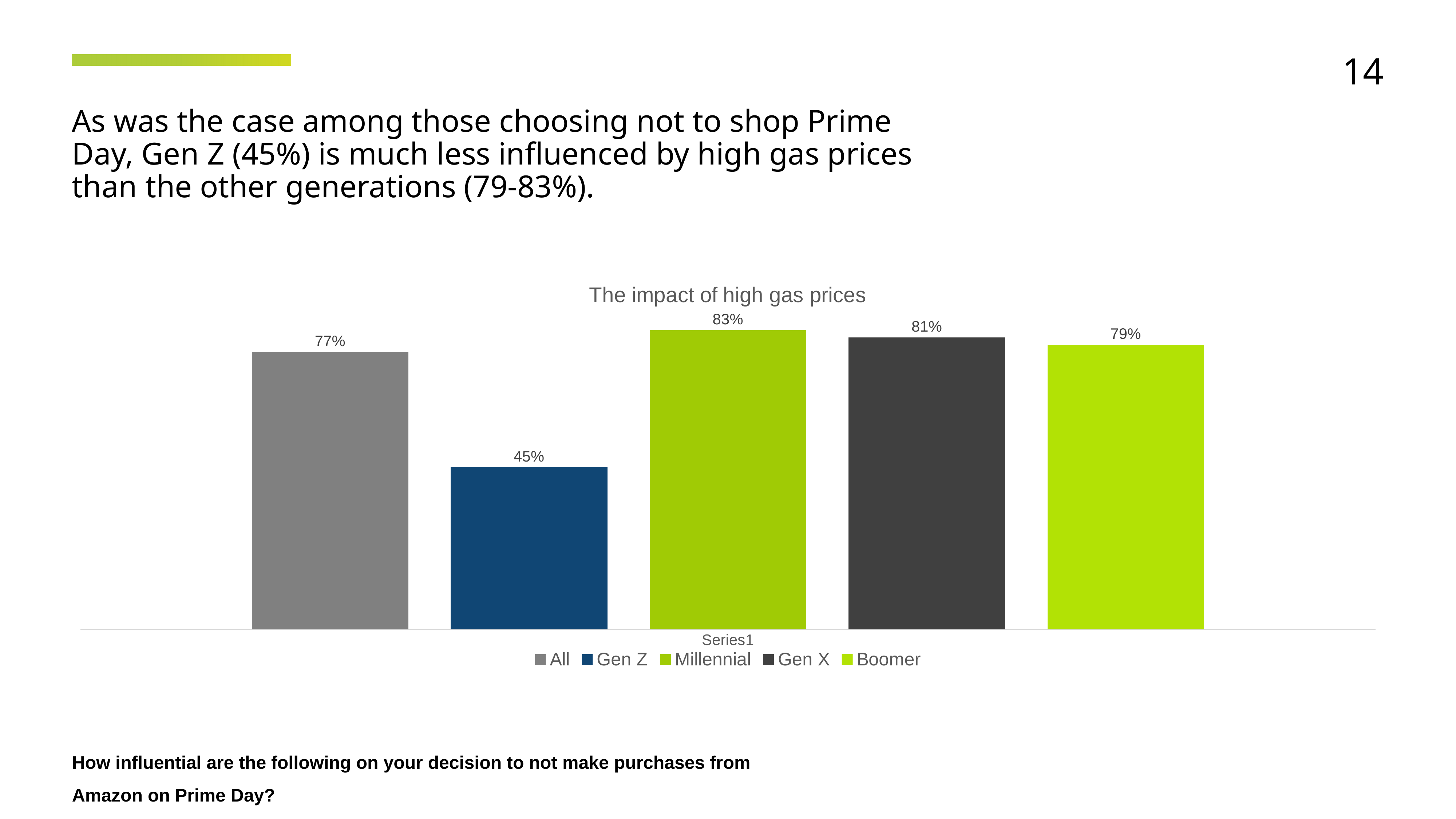
What is the value for All? 77% What is the value for Gen Z? 45% Which group has the highest value? Millennial Which is larger, the value for All or the value for Gen Z? All What is the difference between the Gen X and Boomer values? 2% What is the value for Millennial? 83% Which group has the lowest value? Gen Z What is the title of the chart? The impact of high gas prices How many bars are shown in the chart? 5 What is the difference between the Millennial and Gen Z values? 38% What is the value for Boomer? 79% How many entries does the legend list? 5